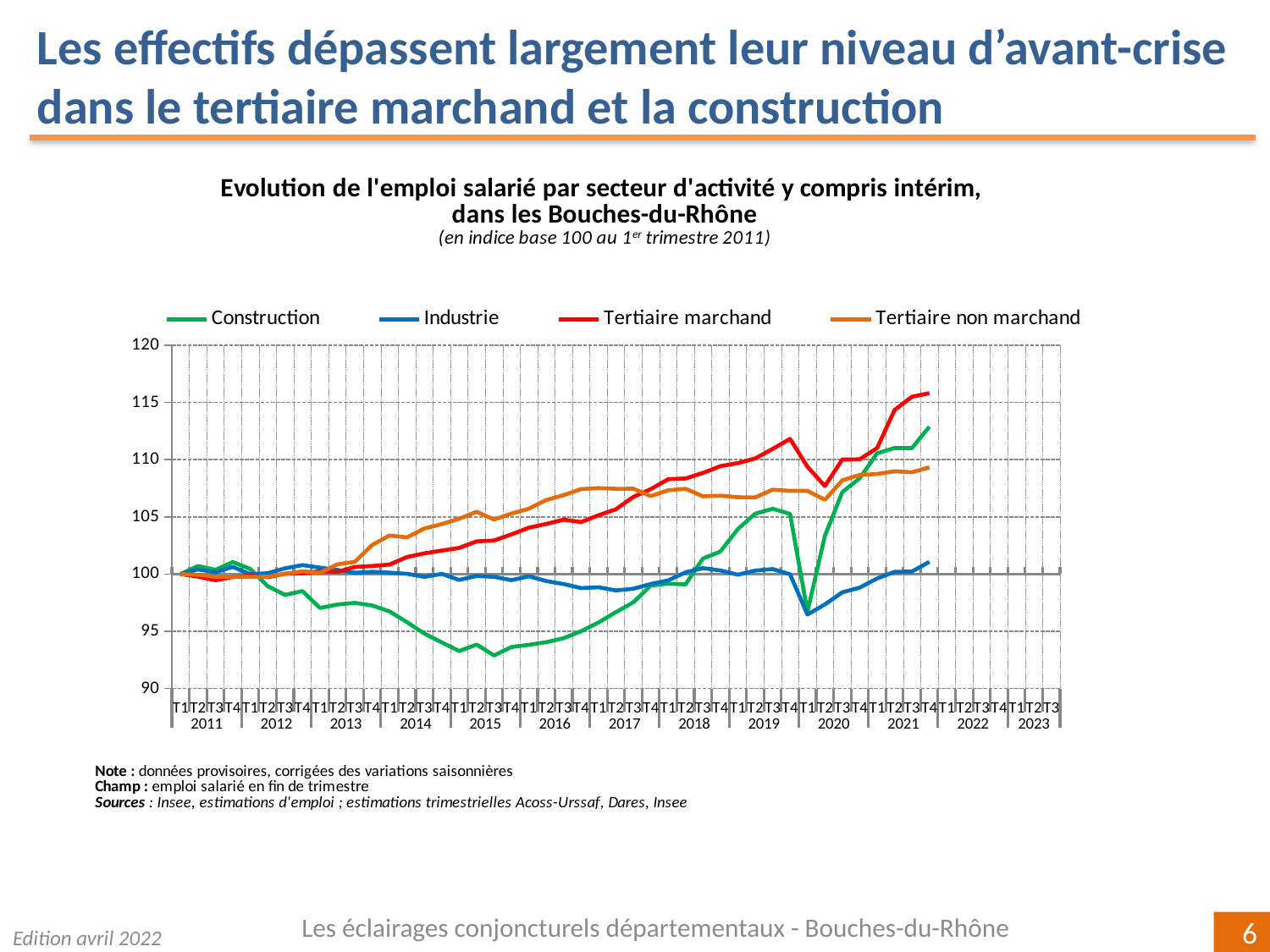
Is the value for Tertiaire marchand at T4 2021 greater or less than 110? greater What kind of chart is shown on the slide? line chart Does the Tertiaire marchand series overall rise or fall from 2011 to 2021? rise How many series does the legend list? 4 Which series has the lowest value during 2015? Construction What colour is the Construction line? green Is the value for Industrie at T1 2020 greater or less than 100? less At T1 2017, which is higher: Tertiaire marchand or Tertiaire non marchand? Tertiaire non marchand Is the lowest value of the Construction series (around 2015) greater or less than 95? less Which series has the lowest value at the last plotted quarter (T4 2021)? Industrie Which series has the highest value at the last plotted quarter (T4 2021)? Tertiaire marchand